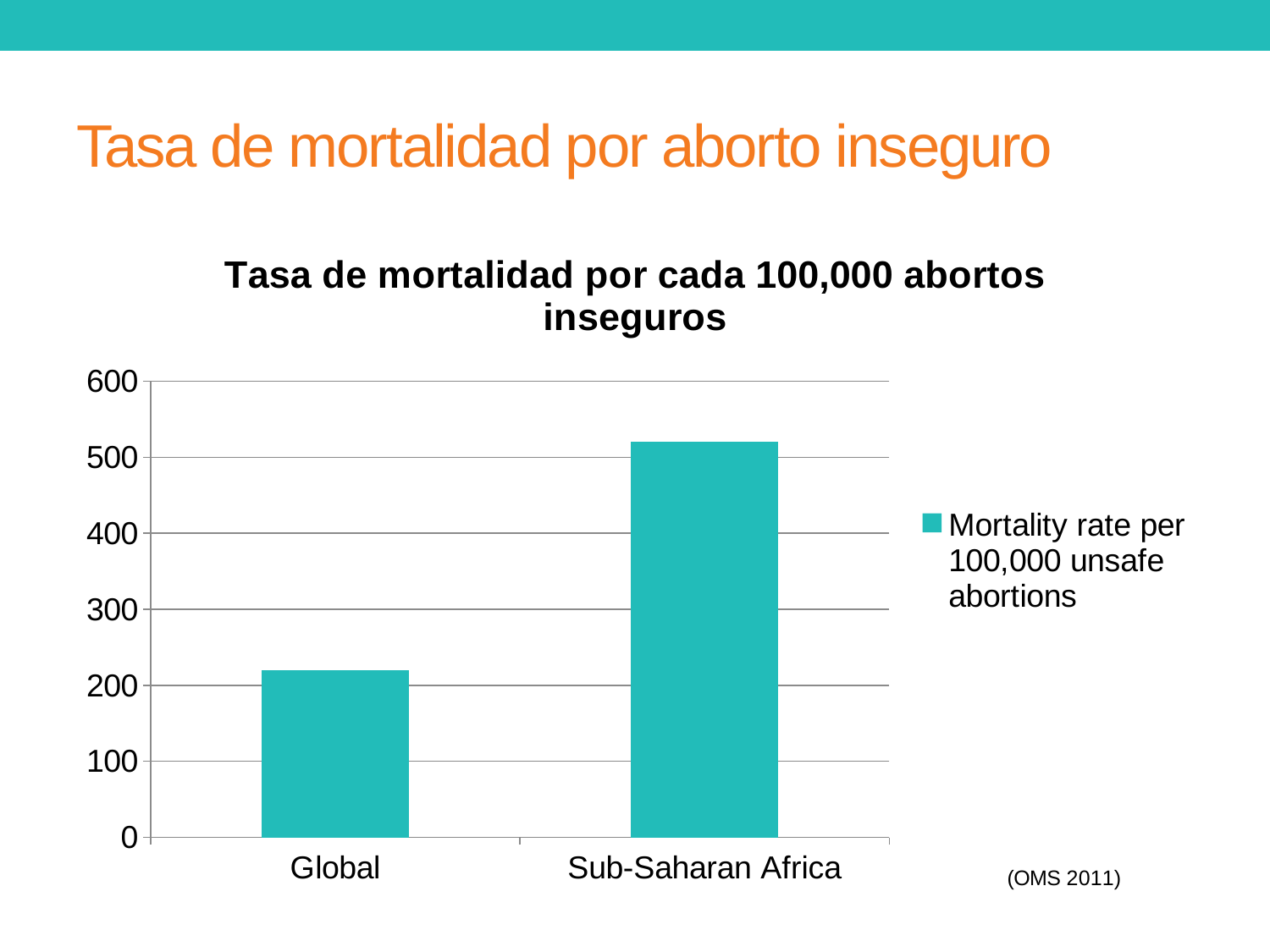
Which is larger, the value for Global or the value for Sub-Saharan Africa? Sub-Saharan Africa Is the value for Sub-Saharan Africa greater or less than 600? less What is the series name shown in the legend? Mortality rate per 100,000 unsafe abortions Is the value for Sub-Saharan Africa greater or less than 500? greater Which category has the lowest mortality rate? Global What is the title of the chart? Tasa de mortalidad por cada 100,000 abortos inseguros How many series does the legend list? 1 Which category has the highest mortality rate? Sub-Saharan Africa Is the value for Global greater or less than 300? less How many categories are shown on the x axis of the chart? 2 What kind of chart is shown on the slide? bar chart